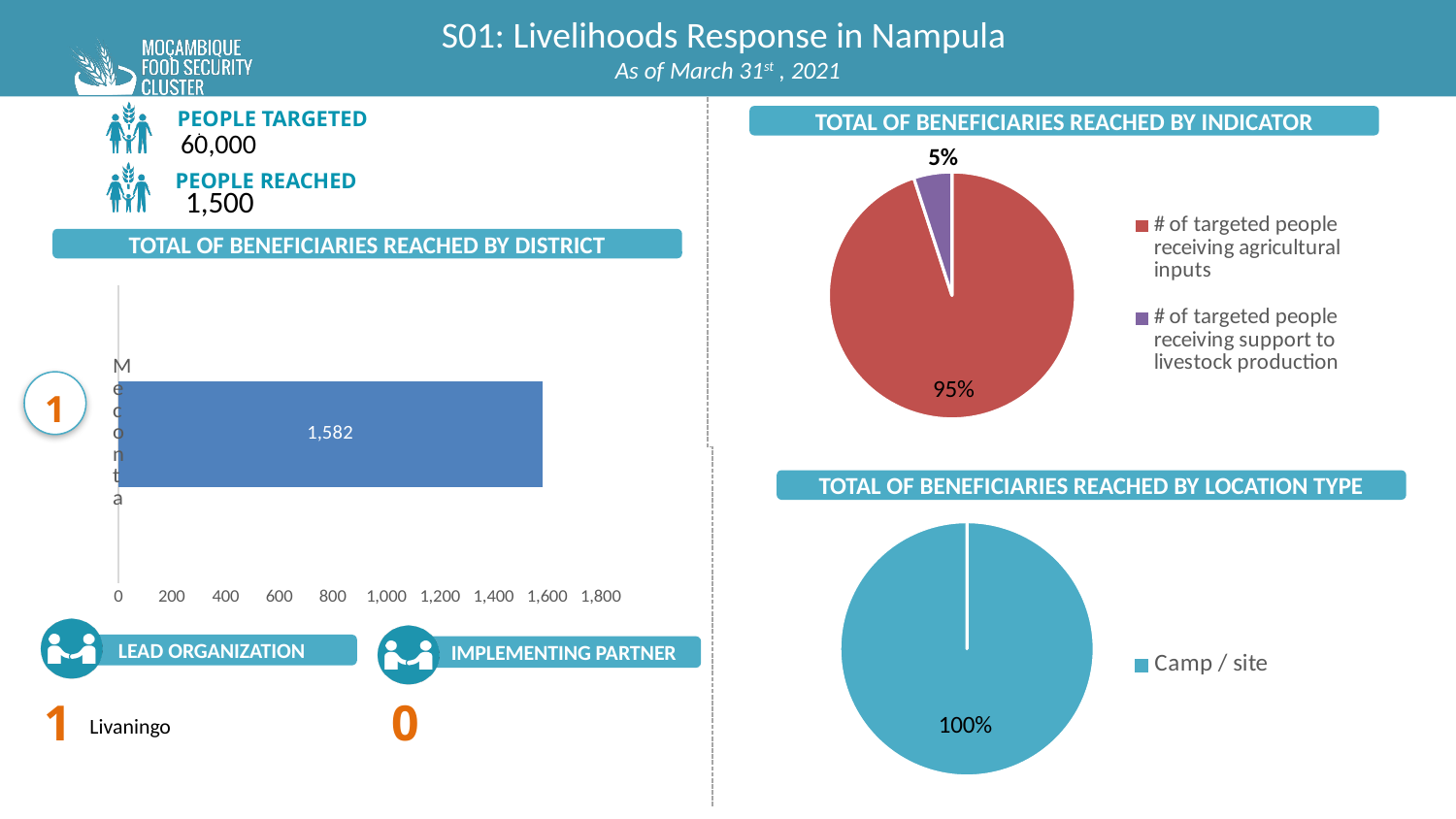
In the 'Total of beneficiaries reached by indicator' chart, what is the difference between the agricultural inputs share and the livestock production share? 90% In the 'Total of beneficiaries reached by indicator' chart, what share is '# of targeted people receiving agricultural inputs'? 95% In the 'Total of beneficiaries reached by district' chart, what is the value for Meconta? 1,582 In the 'Total of beneficiaries reached by district' chart, is the value for Meconta greater or less than 1,400? greater In the 'Total of beneficiaries reached by indicator' chart, which indicator has the largest slice? # of targeted people receiving agricultural inputs In the 'Total of beneficiaries reached by indicator' chart, which indicator has the smallest slice? # of targeted people receiving support to livestock production What kind of chart is the 'Total of beneficiaries reached by location type' chart? pie chart What kind of chart is the 'Total of beneficiaries reached by district' chart? bar chart In the 'Total of beneficiaries reached by indicator' chart, what share is '# of targeted people receiving support to livestock production'? 5% How many districts are shown in the 'Total of beneficiaries reached by district' chart? 1 In the 'Total of beneficiaries reached by location type' chart, what share is 'Camp / site'? 100% How many entries does the legend of the 'Total of beneficiaries reached by indicator' chart list? 2